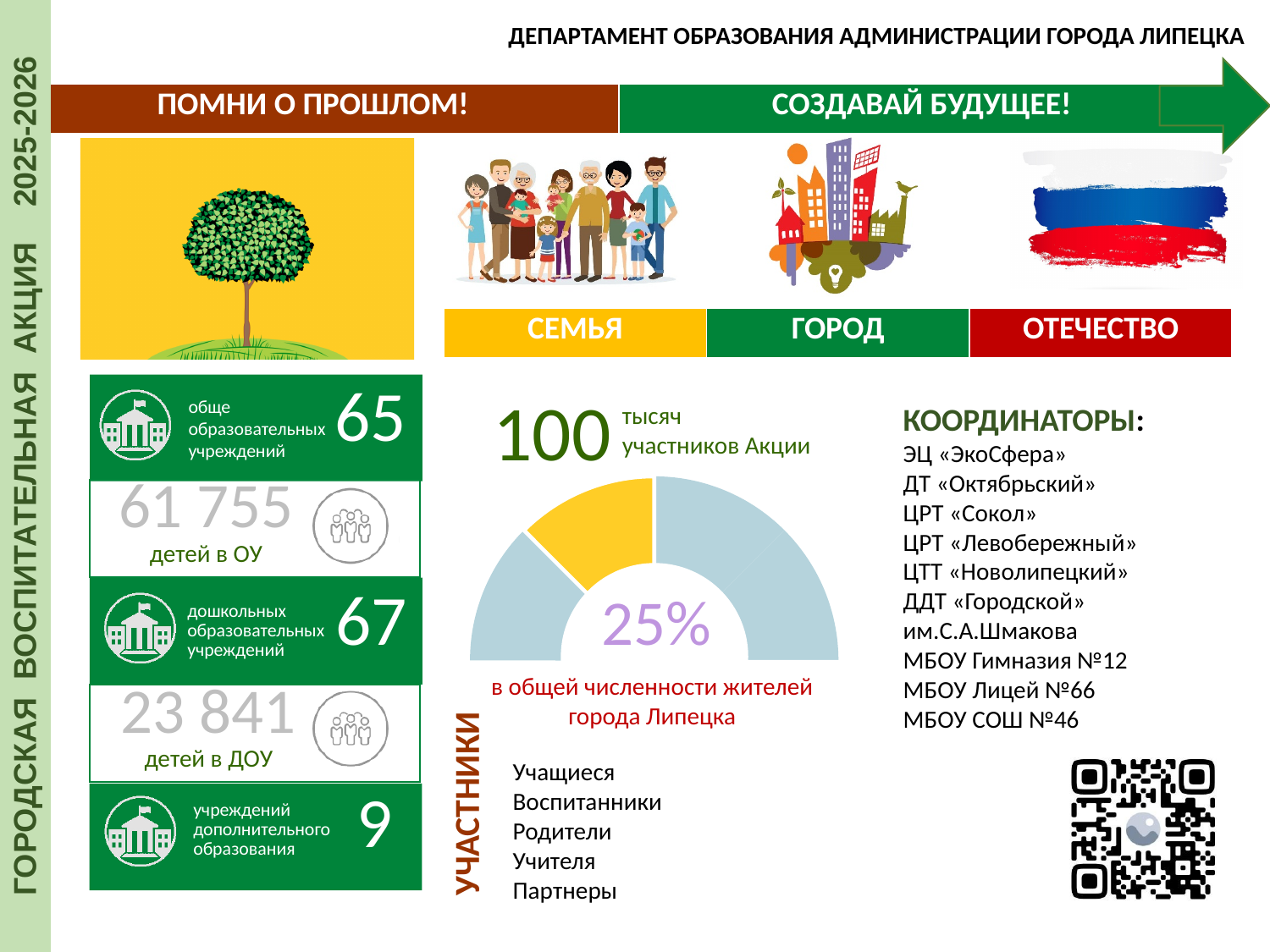
What kind of chart is shown below the text "100 тысяч участников Акции"? doughnut chart What colour is the segment of the doughnut chart that corresponds to 25%? yellow What share of the semicircular doughnut chart is taken by the light blue segment, given the yellow segment is 25%? 75% Which segment of the semicircular doughnut chart is larger, the yellow one or the light blue one? light blue What share of the semicircular doughnut chart does the yellow segment represent? 25% Is the share shown by the yellow segment of the doughnut chart greater or less than 50%? less How many segments does the semicircular doughnut chart have? 2 What percentage value is printed inside the semicircular chart? 25% According to the caption under the doughnut chart, 25% is the share of what? в общей численности жителей города Липецка